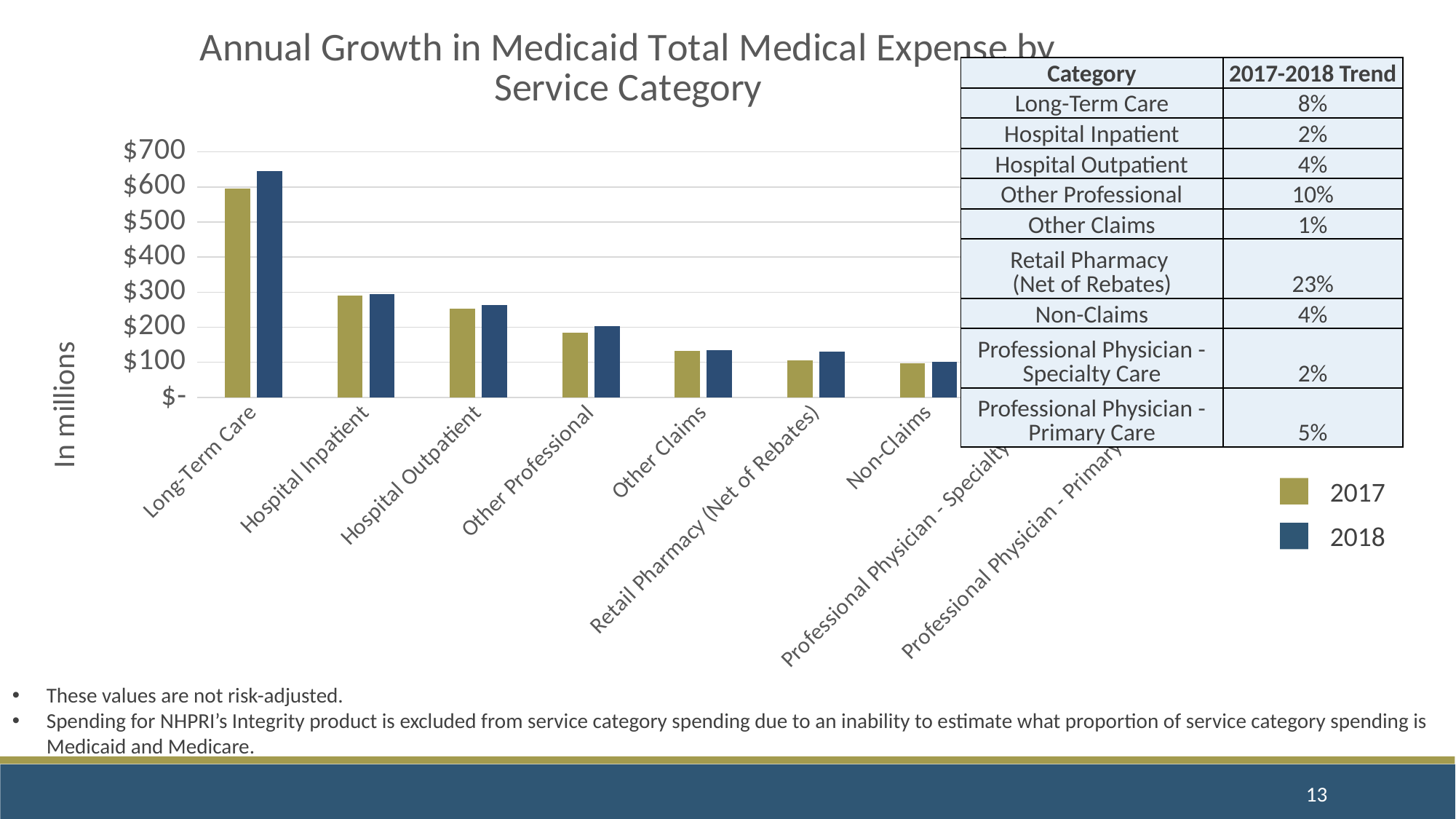
In 2017, which is larger, Hospital Inpatient or Hospital Outpatient? Hospital Inpatient Do the bar values generally rise or fall moving from left to right along the x axis? Fall Which service category has the highest Medicaid total medical expense in the chart? Long-Term Care How many series does the chart legend list? 2 Is the 2018 value for Other Claims greater or less than $100? greater Is the 2018 value for Long-Term Care greater or less than $600? greater Which two series are listed in the chart legend? 2017 and 2018 Is the 2018 value for Hospital Outpatient greater or less than $300? less For Retail Pharmacy (Net of Rebates), which year has the larger value, 2017 or 2018? 2018 For Long-Term Care, which year has the larger value, 2017 or 2018? 2018 What kind of chart is shown on the slide? Bar chart